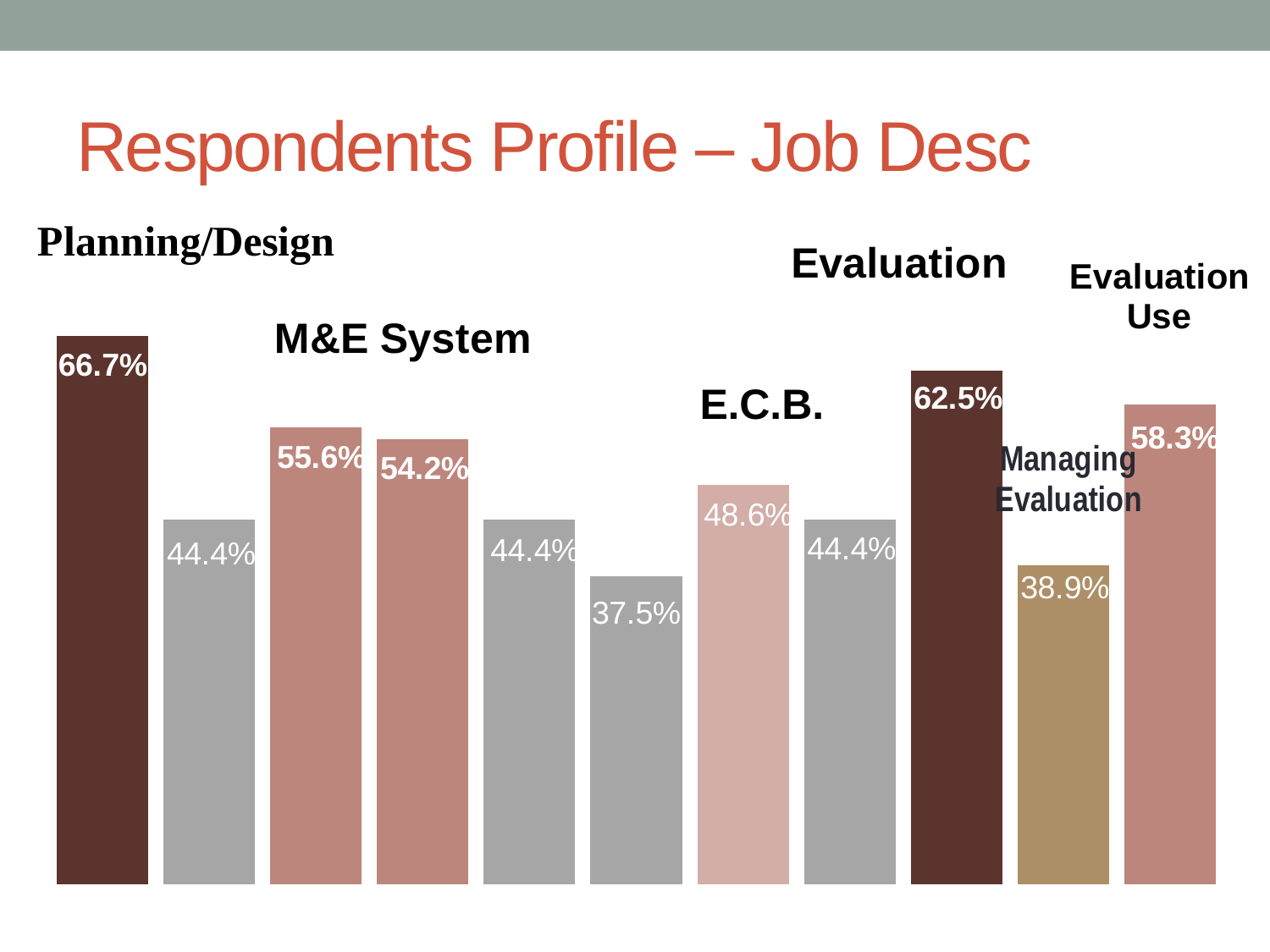
What is the value shown for E.C.B.? 48.6% What is the title of the slide? Respondents Profile – Job Desc Which is larger, the value for Evaluation or the value for Evaluation Use? Evaluation What is the value shown for Planning/Design? 66.7% Which labelled category has the highest value? Planning/Design What is the value shown for Evaluation? 62.5% What is the value shown for Evaluation Use? 58.3% What kind of chart is shown on the slide? Bar chart What is the lowest value printed on any bar in the chart? 37.5% What is the difference between the value for Planning/Design and the value for Evaluation? 4.2 percentage points What is the value shown for Managing Evaluation? 38.9% How many bars are in the chart? 11